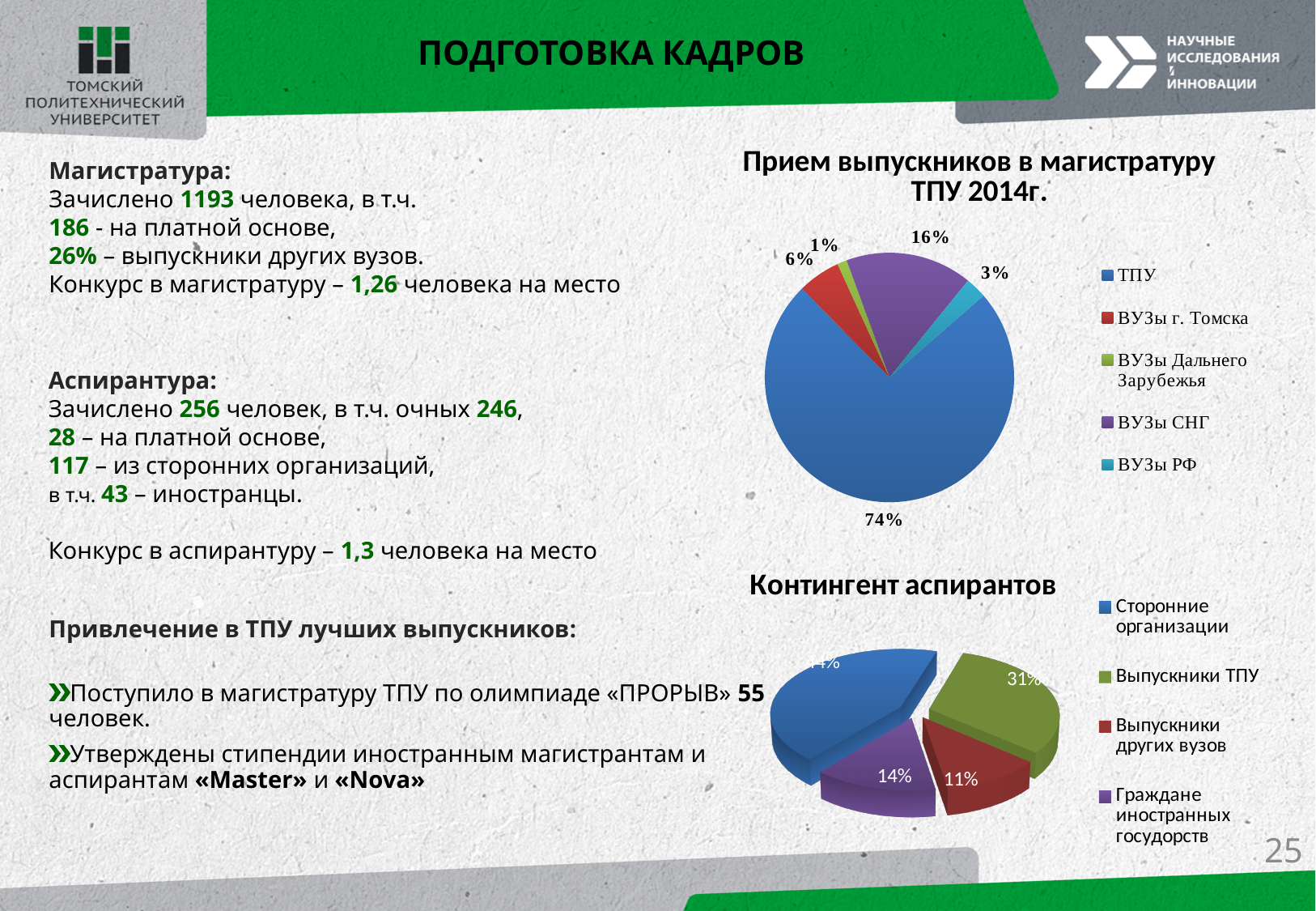
In the chart 'Контингент аспирантов', which is larger: Выпускники других вузов or Граждане иностранных государств? Граждане иностранных государств In the chart 'Контингент аспирантов', which category has the largest share? Сторонние организации What kind of chart is 'Контингент аспирантов'? Pie chart In the chart 'Прием выпускников в магистратуру ТПУ 2014г.', what is the difference between the shares of ВУЗы СНГ and ВУЗы г. Томска? 10% In the chart 'Прием выпускников в магистратуру ТПУ 2014г.', what share is ВУЗы СНГ? 16% In the chart 'Прием выпускников в магистратуру ТПУ 2014г.', what share of the pie is ТПУ? 74% In the chart 'Контингент аспирантов', how many categories does the legend list? 4 In the chart 'Прием выпускников в магистратуру ТПУ 2014г.', how many categories does the legend list? 5 In the chart 'Контингент аспирантов', what share is Граждане иностранных государств? 14% In the chart 'Прием выпускников в магистратуру ТПУ 2014г.', which category has the smallest share? ВУЗы Дальнего Зарубежья In the chart 'Контингент аспирантов', what share is Выпускники ТПУ? 31% In the chart 'Прием выпускников в магистратуру ТПУ 2014г.', what share is ВУЗы РФ? 3%